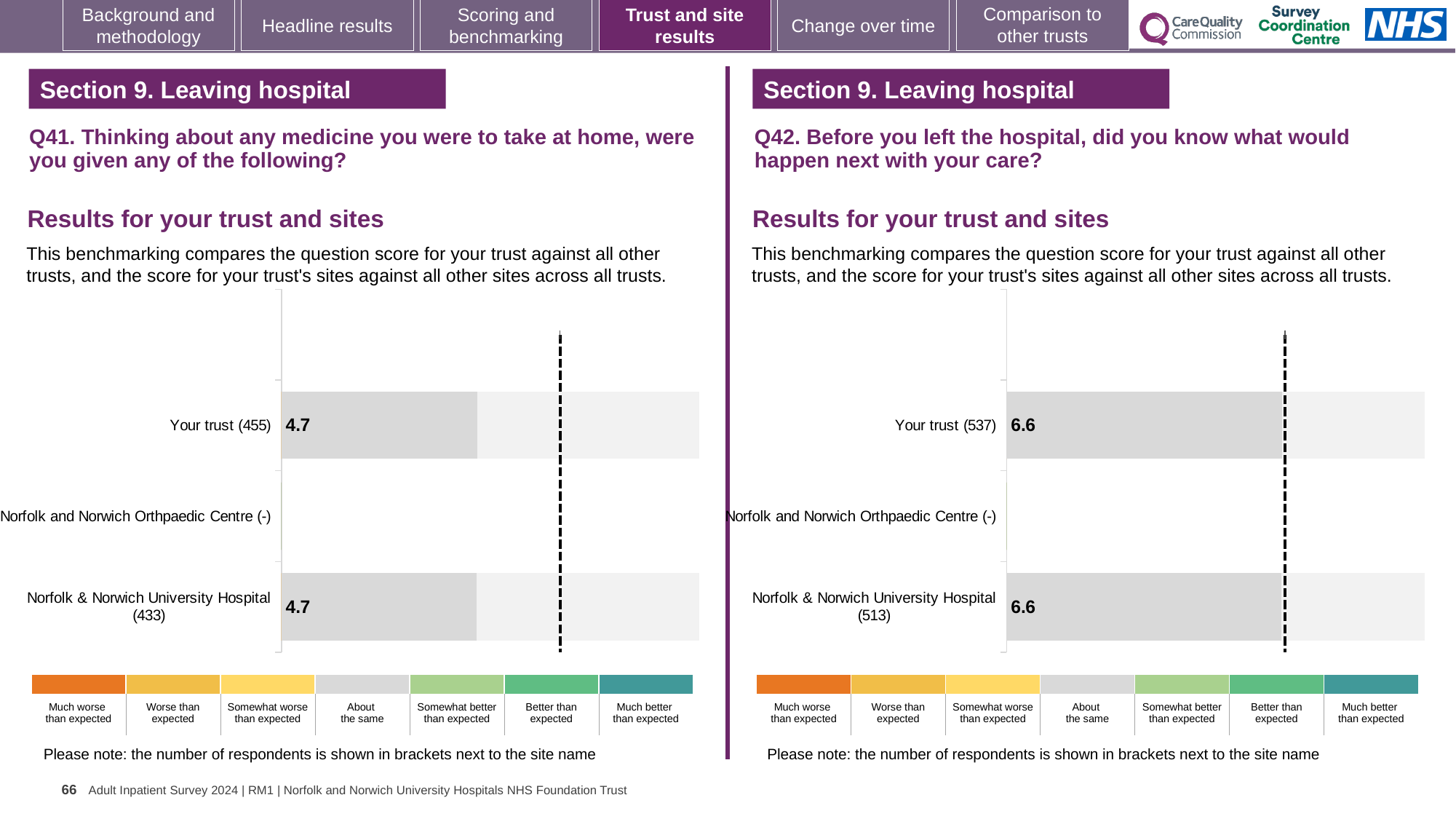
In the Q41 chart on the left, what is the score for Your trust? 4.7 In the Q42 chart on the right, what is the difference between the score for Your trust and the score for Norfolk & Norwich University Hospital? 0.0 In the Q42 chart on the right, is the score for Your trust greater or less than the score for Norfolk & Norwich University Hospital, or are they equal? Equal In the Q41 chart on the left, which category has no bar plotted? Norfolk and Norwich Orthpaedic Centre (-) In the Q42 chart on the right, what is the score for Norfolk & Norwich University Hospital? 6.6 In the Q42 chart on the right, how many respondents are shown in brackets for Norfolk & Norwich University Hospital? 513 In the Q41 chart on the left, how many site/trust categories are listed on the vertical axis? 3 What kind of chart is the Q41 chart on the left? Bar chart In the Q42 chart on the right, how many site/trust categories are listed on the vertical axis? 3 In the Q42 chart on the right, what is the score for Your trust? 6.6 In the Q41 chart on the left, how many respondents are shown in brackets for Your trust? 455 In the Q41 chart on the left, what is the score for Norfolk & Norwich University Hospital? 4.7